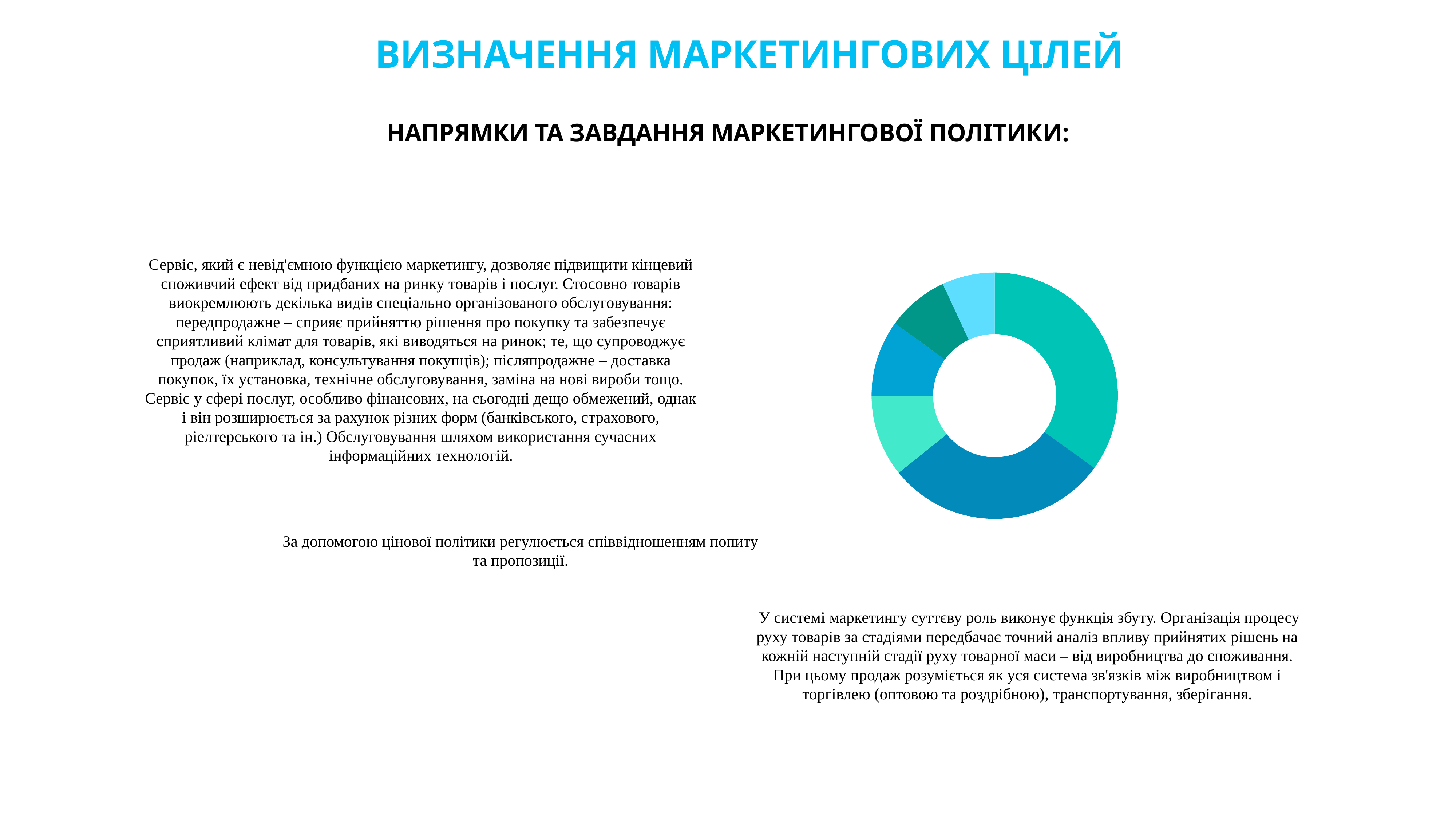
In the doughnut chart, which is larger: the teal slice on the right or the light cyan slice at the top? The teal slice on the right Does the doughnut chart on the slide show data labels with values? No What kind of chart is shown on the right side of the slide? Doughnut chart Does the doughnut chart on the slide display a legend? No In the doughnut chart, which is larger: the dark blue slice at the bottom or the blue slice on the left? The dark blue slice at the bottom How many slices does the doughnut chart on the slide have? 6